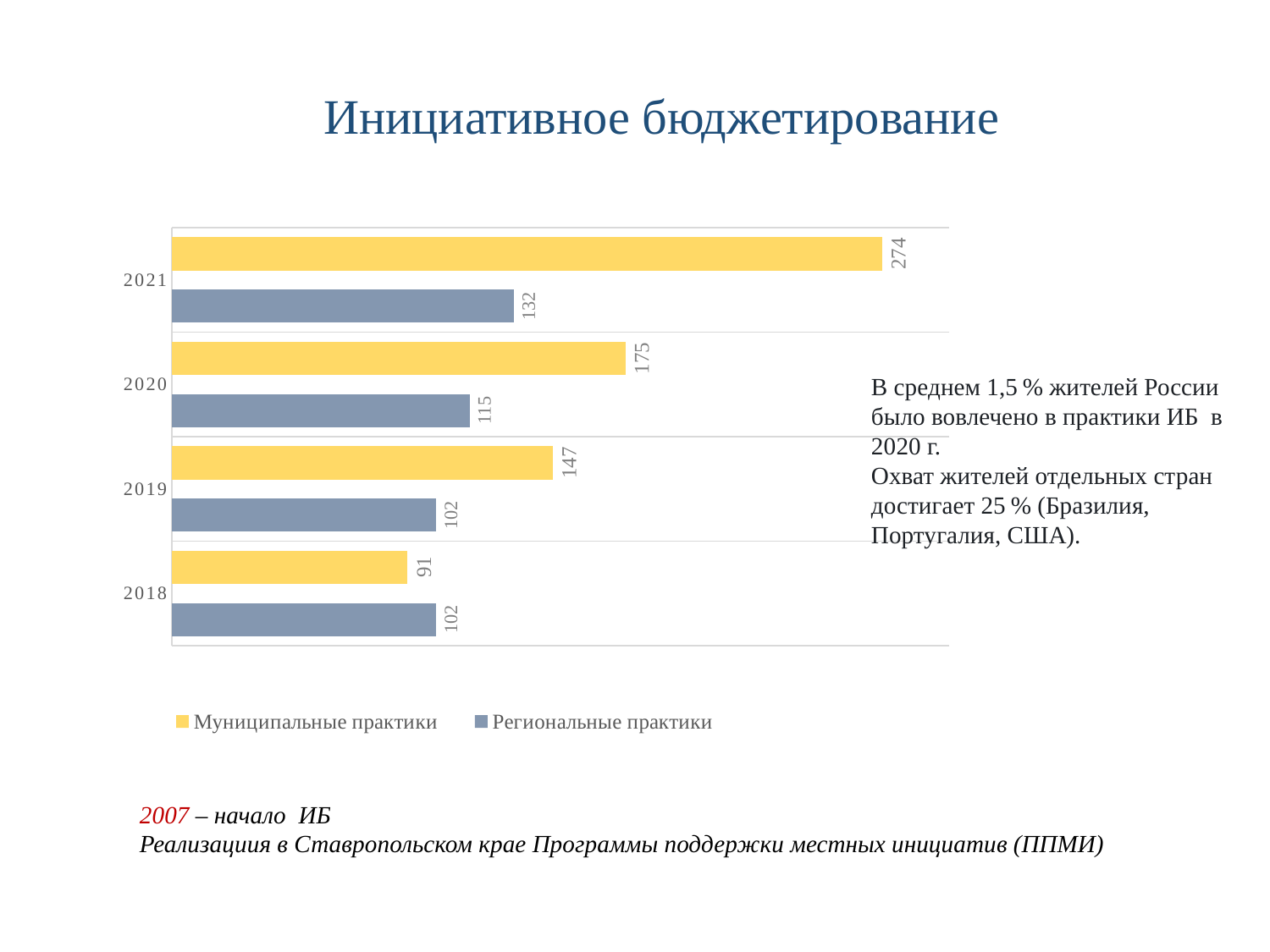
What colour are the bars for Муниципальные практики? Yellow Which year has the lowest value for Региональные практики? 2018 and 2019 (both 102) What is the value of Региональные практики for 2020? 115 How many years are shown on the chart? 4 Which year has the highest value for Муниципальные практики? 2021 Does the value of Муниципальные практики rise or fall from 2018 to 2021? Rise How many series does the legend list? 2 What kind of chart is shown on the slide? Bar chart What is the difference between Муниципальные практики and Региональные практики in 2021? 142 What is the value of Муниципальные практики for 2018? 91 In 2018, which series has the larger value: Муниципальные практики or Региональные практики? Региональные практики What is the value of Муниципальные практики for 2021? 274